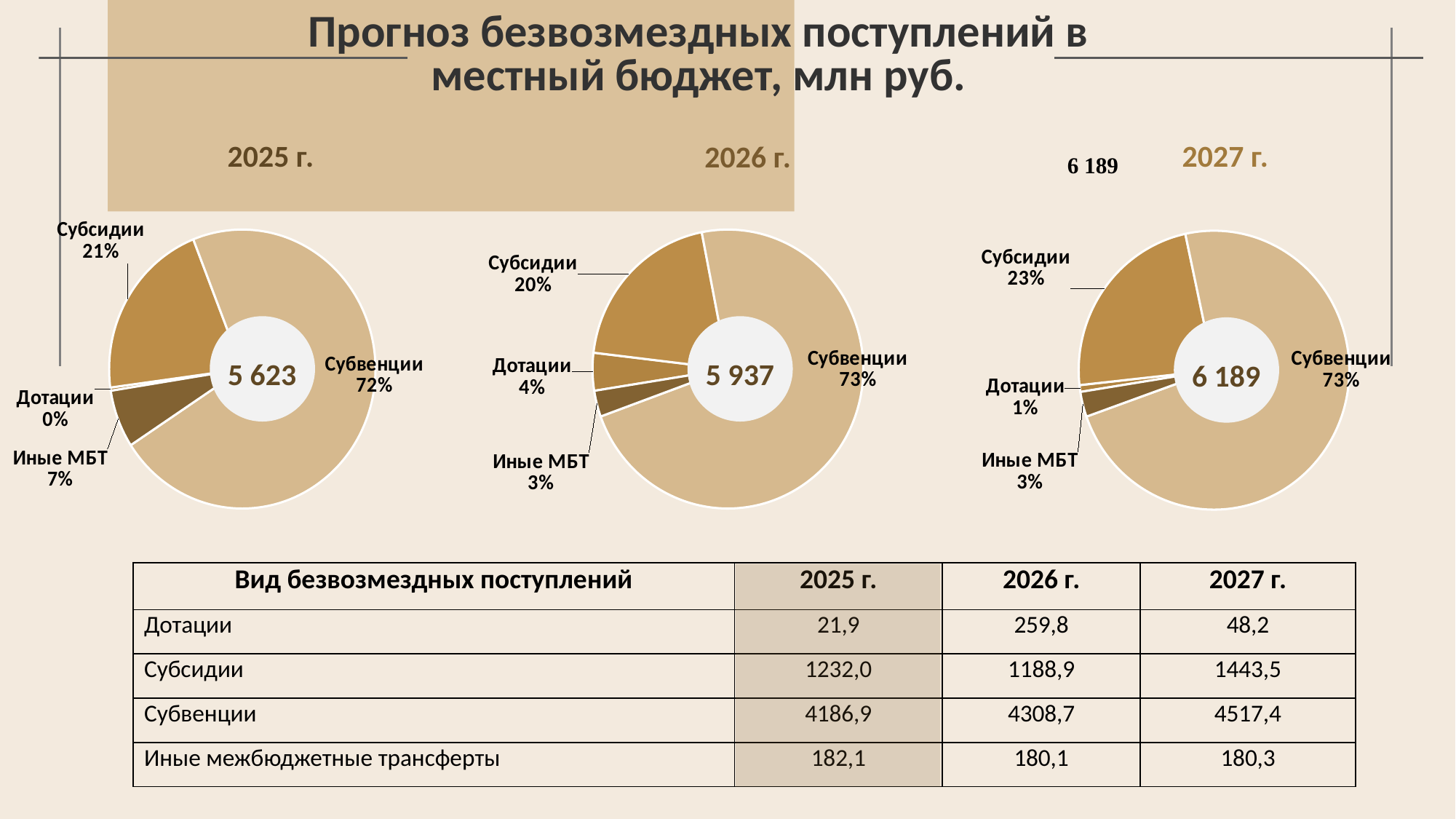
In the 2026 г. chart, which category has the largest share? Субвенции In the 2027 г. chart, what is the difference in percentage points between Субвенции and Субсидии? 50 What total value is shown in the centre of the 2027 г. chart? 6 189 How many slices does the 2026 г. chart have? 4 In the 2025 г. chart, what share does Иные МБТ have? 7% In the 2026 г. chart, what share does Дотации have? 4% In the 2026 г. chart, which is larger: the share of Дотации or the share of Иные МБТ? Дотации In the 2025 г. chart, what share does Субвенции have? 72% What total value is shown in the centre of the 2025 г. chart? 5 623 What type of chart is used for the 2025 г. data? Pie chart In the 2025 г. chart, which category has the smallest share? Дотации